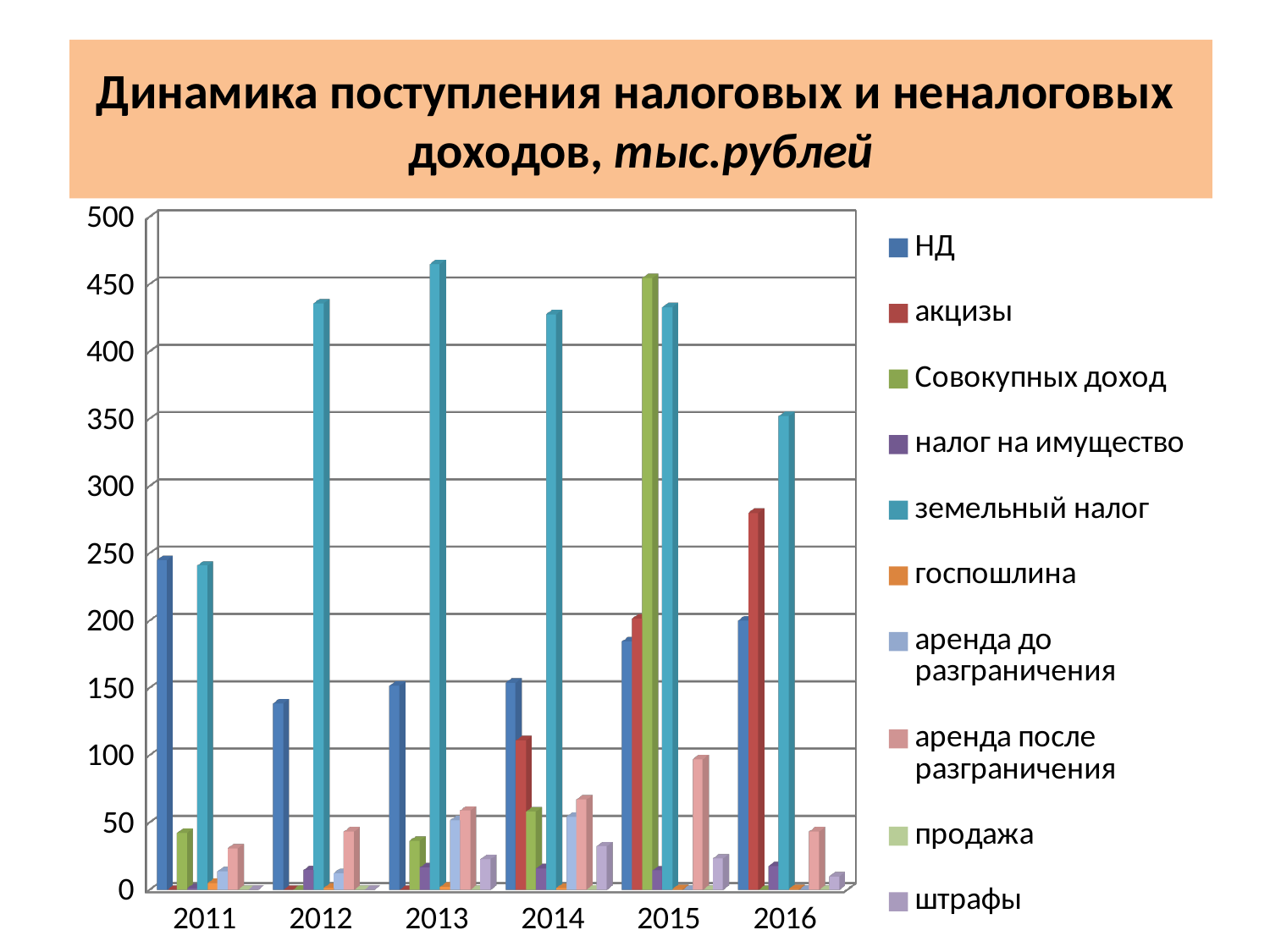
Is the value for НД in 2011 greater or less than 200? greater Is the value for Совокупных доход in 2015 greater or less than 400? greater What kind of chart is shown on the slide? bar chart Is the value for земельный налог in 2013 greater or less than 450? greater In 2012, which is larger: НД or земельный налог? земельный налог In which year is the value for земельный налог the lowest? 2011 How many years are shown on the x axis of the chart? 6 In 2016, which is larger: акцизы or НД? акцизы How many series does the legend list? 10 In which year is the value for земельный налог the highest? 2013 Do the values for акцизы rise or fall from 2011 to 2016? rise What is the title of the chart? Динамика поступления налоговых и неналоговых доходов, тыс.рублей